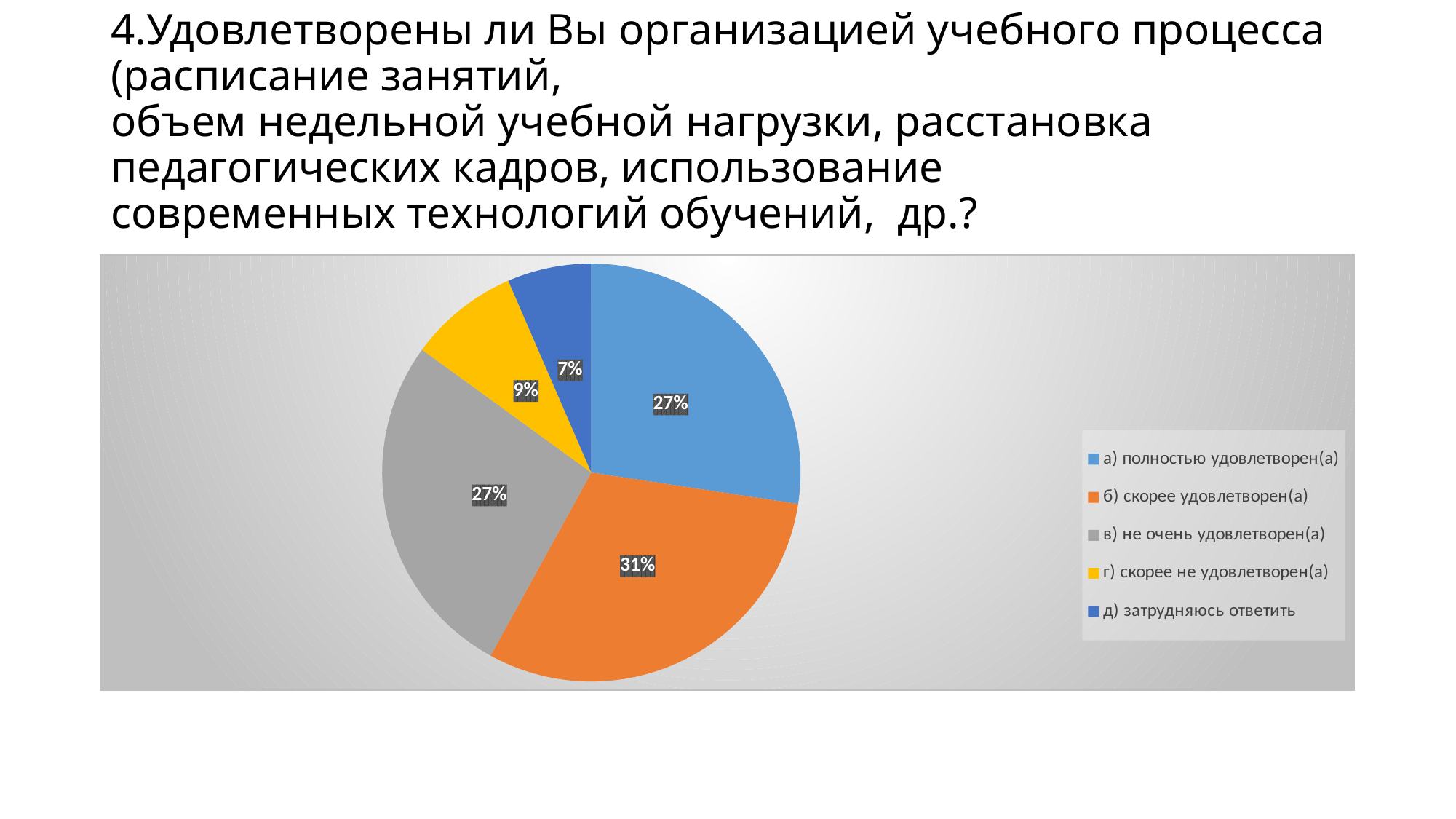
Which is larger, the slice for "г) скорее не удовлетворен(а)" or the slice for "д) затрудняюсь ответить"? г) скорее не удовлетворен(а) What share of the pie is labelled for "б) скорее удовлетворен(а)"? 31% What kind of chart is shown on the slide? pie chart What share of the pie is labelled for "г) скорее не удовлетворен(а)"? 9% What share of the pie is labelled for "д) затрудняюсь ответить"? 7% What is the difference in percentage points between "б) скорее удовлетворен(а)" and "г) скорее не удовлетворен(а)"? 22 What share of the pie is labelled for "а) полностью удовлетворен(а)"? 27% Which category has the smallest slice of the pie? д) затрудняюсь ответить What share of the pie is labelled for "в) не очень удовлетворен(а)"? 27% How many categories does the legend list? 5 What colour is the slice for "г) скорее не удовлетворен(а)"? yellow Which category has the largest slice of the pie? б) скорее удовлетворен(а)